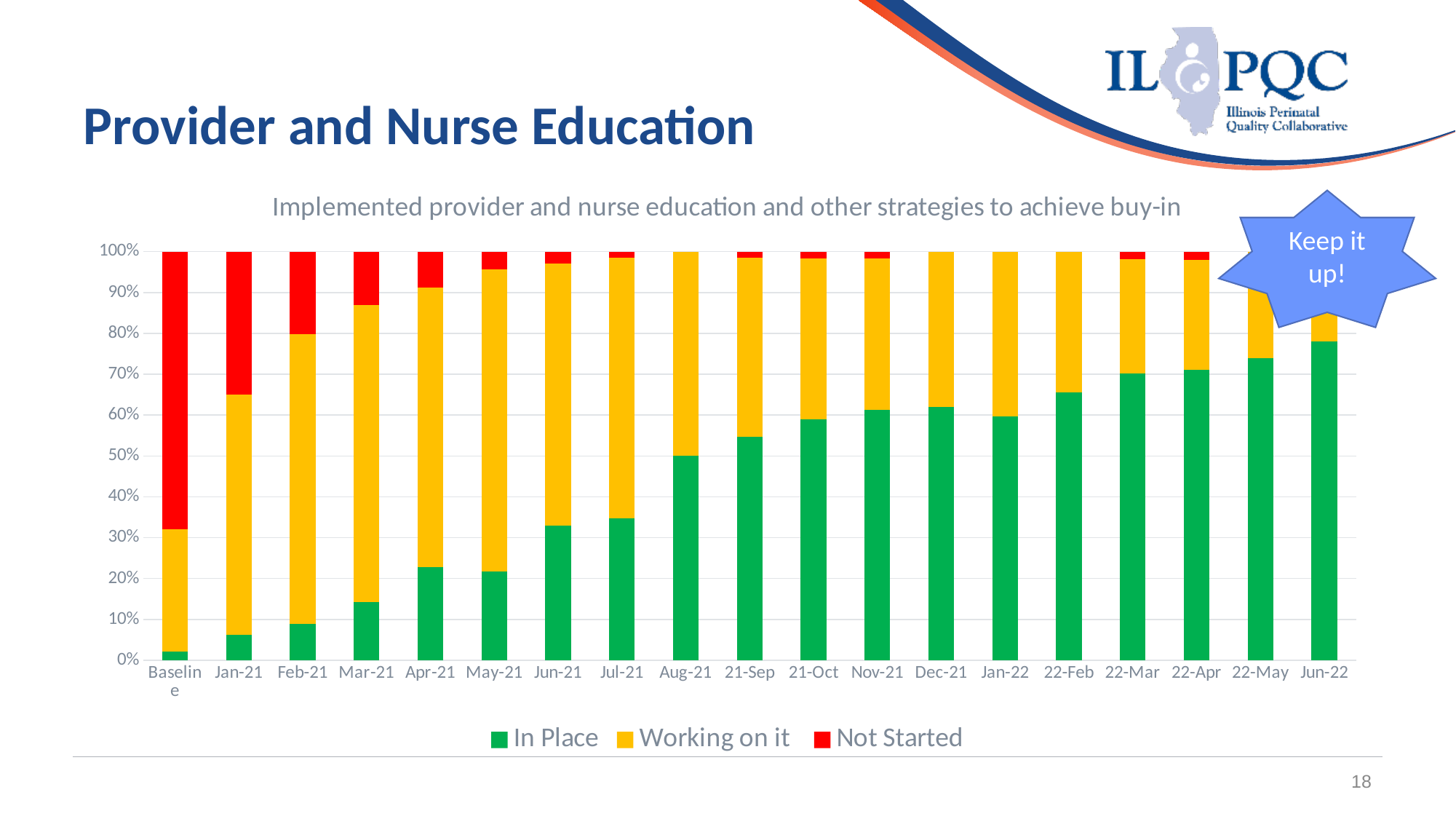
Is the In Place value for 22-Mar greater or less than 60%? greater Does the In Place series generally rise or fall from Baseline to Jun-22? rise What kind of chart is shown on the slide? Stacked bar chart Which is larger, the Not Started value for Baseline or for Jan-21? Baseline Which category has the lowest In Place value? Baseline Is the In Place value for Baseline greater or less than 10%? less What is the chart's title? Implemented provider and nurse education and other strategies to achieve buy-in Which category has the highest In Place value? Jun-22 Is the In Place value for Jun-22 greater or less than 70%? greater How many series does the legend list? 3 How many categories are shown along the x axis? 19